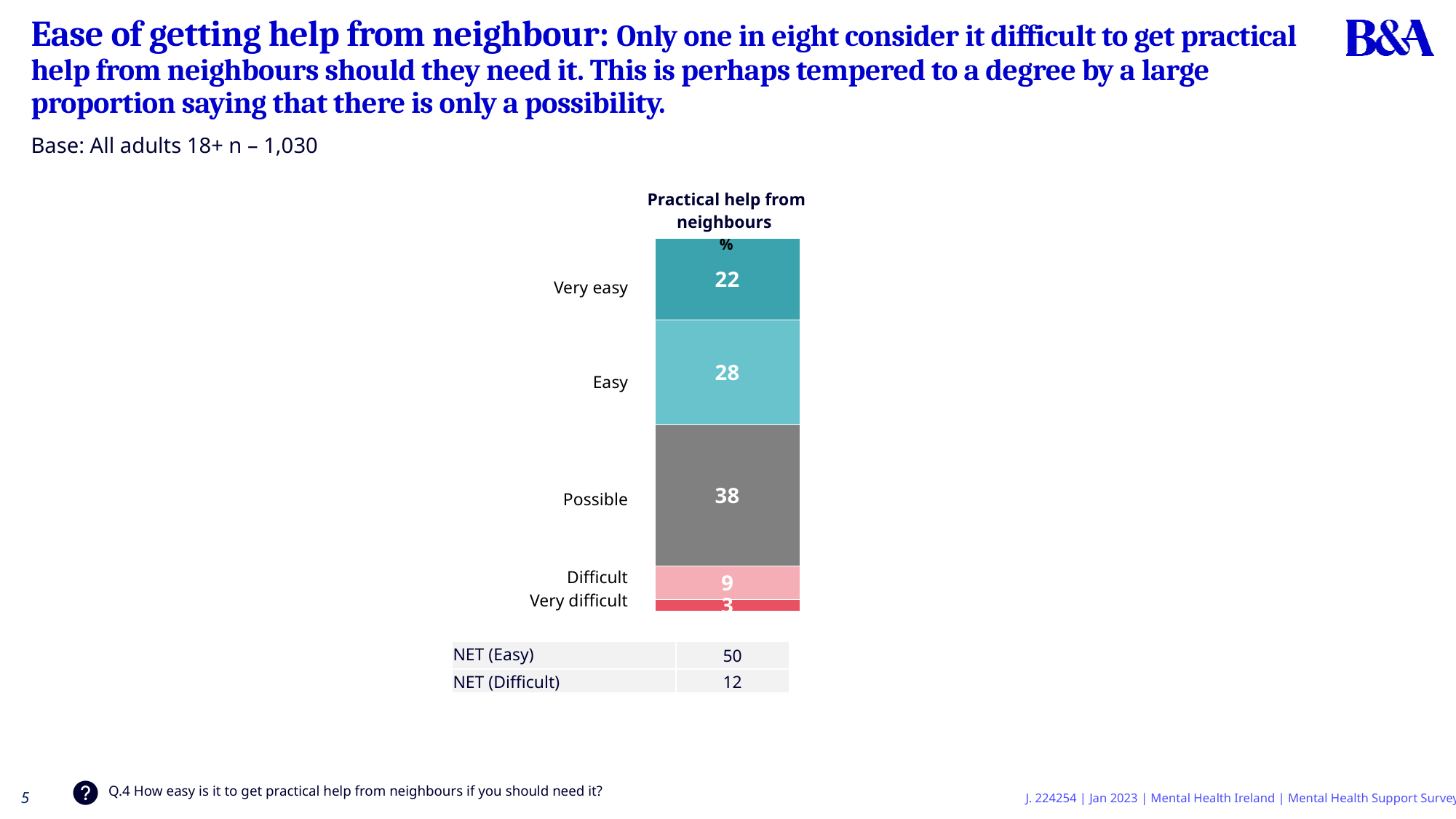
Which is larger, the value for 'Very easy' or the value for 'Easy'? Easy What kind of chart is shown on the slide? Stacked bar chart What percentage of respondents say it is 'Very easy' to get practical help from neighbours? 22 What is the value for 'Difficult' in the Practical help from neighbours chart? 9 How many categories are shown in the stacked bar? 5 Which category has the highest value in the Practical help from neighbours chart? Possible What is the difference between the 'Possible' and 'Easy' values? 10 What is the value for 'Very difficult' in the Practical help from neighbours chart? 3 Which category has the lowest value in the Practical help from neighbours chart? Very difficult What is the value for 'Possible' in the Practical help from neighbours chart? 38 What is the value for 'Easy' in the Practical help from neighbours chart? 28 What is the NET (Difficult) value shown below the chart? 12